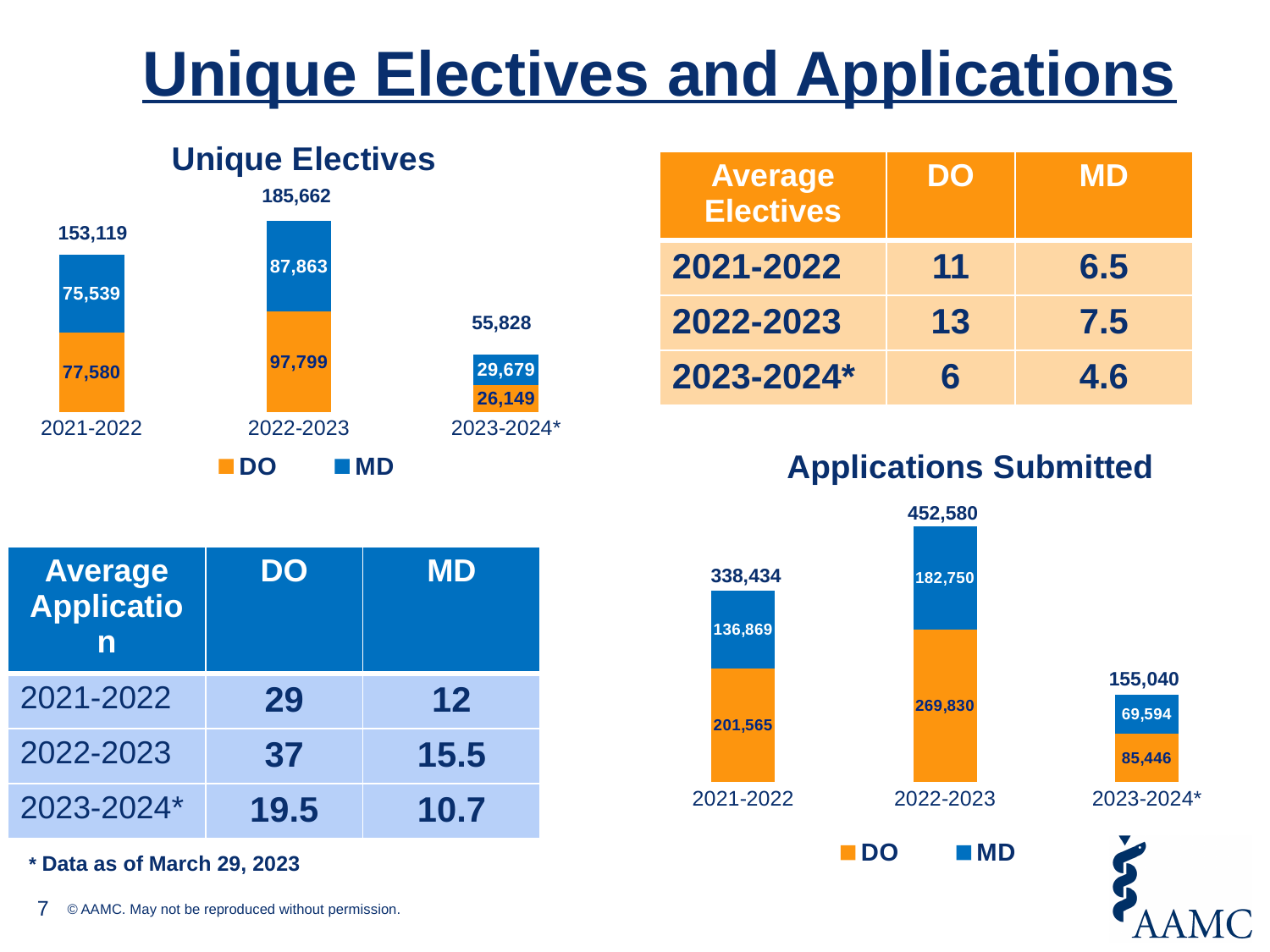
In the Applications Submitted chart, which year has the lowest total? 2023-2024* In the Unique Electives chart, what is the DO value for 2022-2023? 97,799 In the Unique Electives chart, what is the MD value for 2023-2024*? 29,679 In the Unique Electives chart, what is the total of the stacked bar for 2021-2022? 153,119 In the Applications Submitted chart, is the DO value or the MD value larger for 2022-2023? DO In the Applications Submitted chart, what is the DO value for 2021-2022? 201,565 In the Applications Submitted chart, what is the total of the stacked bar for 2023-2024*? 155,040 In the Applications Submitted chart, what is the MD value for 2022-2023? 182,750 In the Applications Submitted chart, what is the difference between the totals for 2022-2023 and 2021-2022? 114,146 In the Unique Electives chart, which year has the highest total? 2022-2023 In the Unique Electives chart, what is the difference between the DO and MD values for 2022-2023? 9,936 How many series does the legend of the Unique Electives chart list? 2